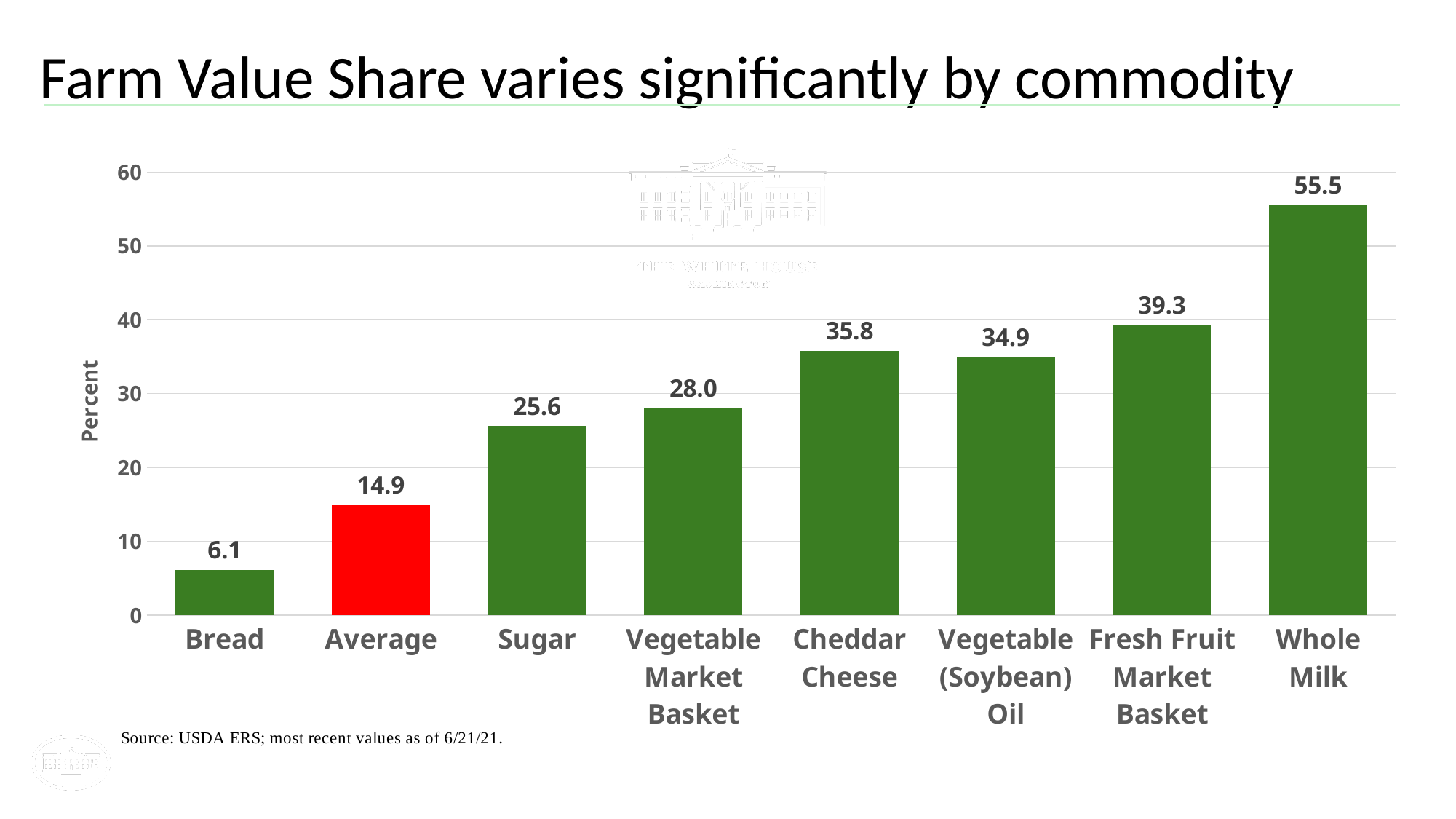
Which commodity has the highest farm value share? Whole Milk Which bar is coloured red rather than green? Average Which category has the lowest value on the chart? Bread What is the value for Cheddar Cheese? 35.8 Do the values generally rise or fall from left to right across the chart? Rise How many bars are shown on the chart? 8 What is the value shown for the Average bar? 14.9 Which is larger, the value for Fresh Fruit Market Basket or Vegetable (Soybean) Oil? Fresh Fruit Market Basket What is the difference between the values for Whole Milk and Bread? 49.4 What kind of chart is shown on the slide? Bar chart What is the farm value share for Whole Milk? 55.5 What is the value shown for Bread? 6.1